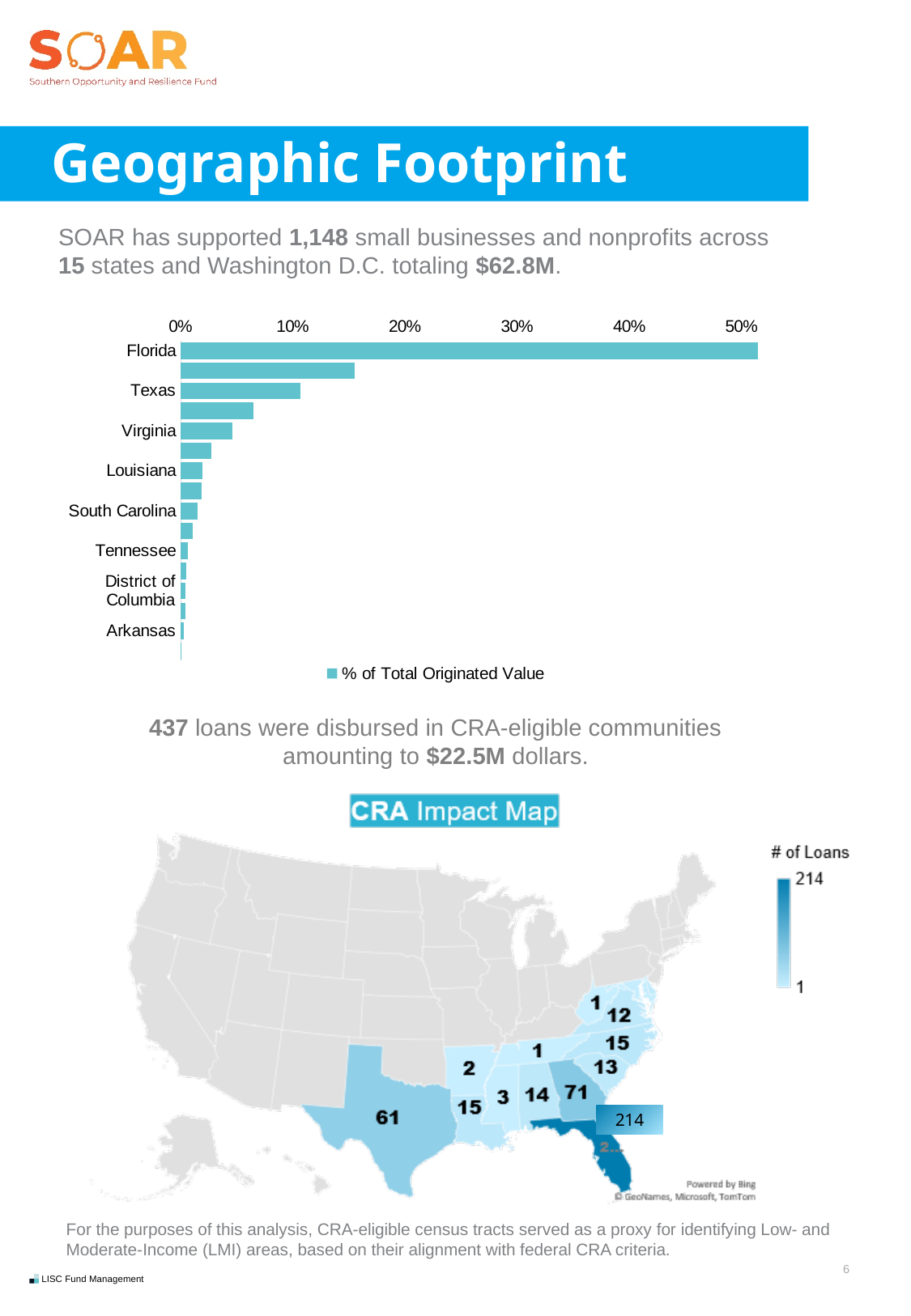
In the CRA Impact Map, what is the difference between the number of loans in Florida and in Texas? 153 How many series does the legend of the '% of Total Originated Value' bar chart list? 1 What is the title of the legend on the CRA Impact Map? # of Loans In the '% of Total Originated Value' bar chart, is the value for Texas greater or less than 20%? less What is the highest tick value shown on the percentage axis of the '% of Total Originated Value' bar chart? 50% In the CRA Impact Map, how many loans are shown for Florida? 214 What kind of chart is the chart with the legend '% of Total Originated Value'? bar chart In the '% of Total Originated Value' bar chart, is the value for Virginia greater or less than 10%? less In the '% of Total Originated Value' bar chart, which is larger, the value for Virginia or the value for Louisiana? Virginia In the '% of Total Originated Value' bar chart, is the value for Florida greater or less than 40%? greater In the CRA Impact Map, how many loans are shown for Texas? 61 In the '% of Total Originated Value' bar chart, which state has the highest share? Florida